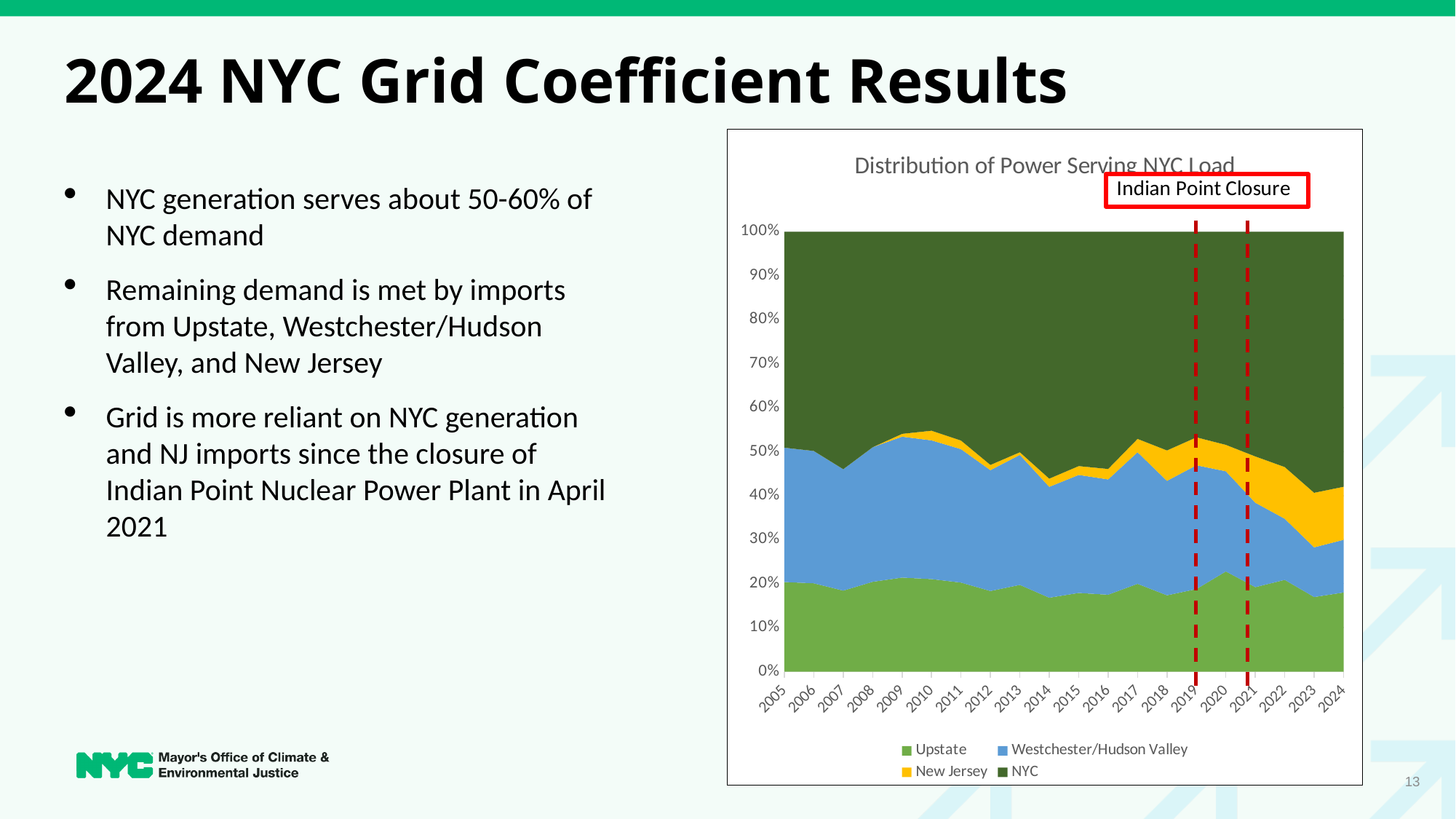
What event is labelled by the red dashed lines on the chart? Indian Point Closure How many years are shown along the x axis of the chart? 20 Does the New Jersey share rise or fall between 2019 and 2024? rise Does the Westchester/Hudson Valley share rise or fall between 2019 and 2023? fall What is the title of the chart? Distribution of Power Serving NYC Load Is the Upstate share in 2023 greater or less than 20%? less Is the Upstate share in 2014 greater or less than 20%? less What is the last year shown on the x axis? 2024 Which series occupies the largest share of the chart in 2024? NYC How many series does the chart legend list? 4 What is the first year shown on the x axis? 2005 What kind of chart is shown on the slide? Stacked area chart